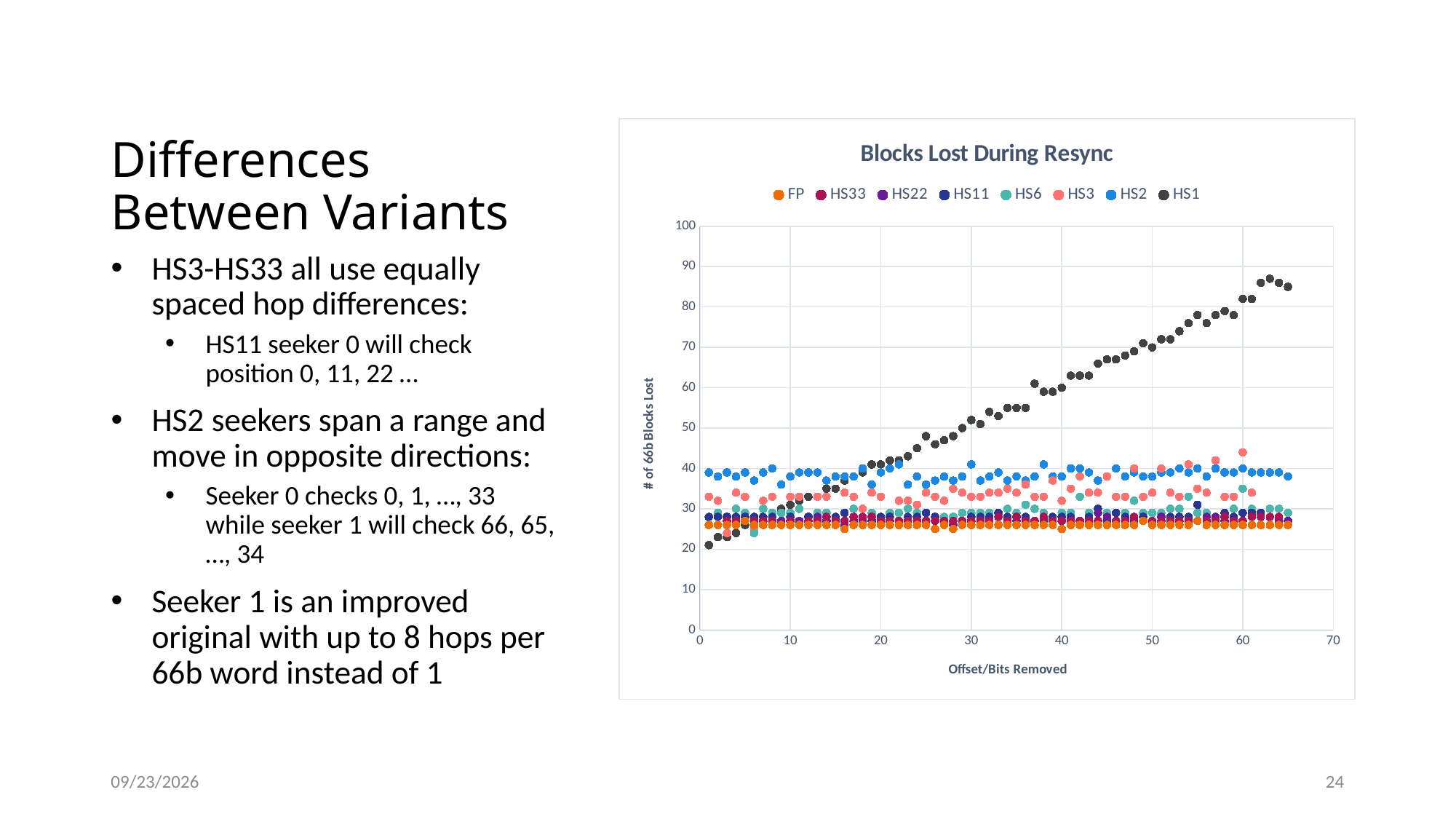
Do the HS1 values rise or fall as the offset increases along the x axis? rise Is the HS1 value at an offset of 10 greater or less than 40? less At an offset of 60, which series has the larger value, HS1 or HS2? HS1 What kind of chart is shown on the slide? scatter chart What is the title of the chart? Blocks Lost During Resync Is the FP value at an offset of 30 greater or less than 30? less How many series does the chart legend list? 8 At an offset of 5, which series has the larger value, HS2 or FP? HS2 Which series reaches the highest number of blocks lost in the chart? HS1 What is the label of the x axis of the chart? Offset/Bits Removed Is the HS1 value at an offset of 50 greater or less than 60? greater